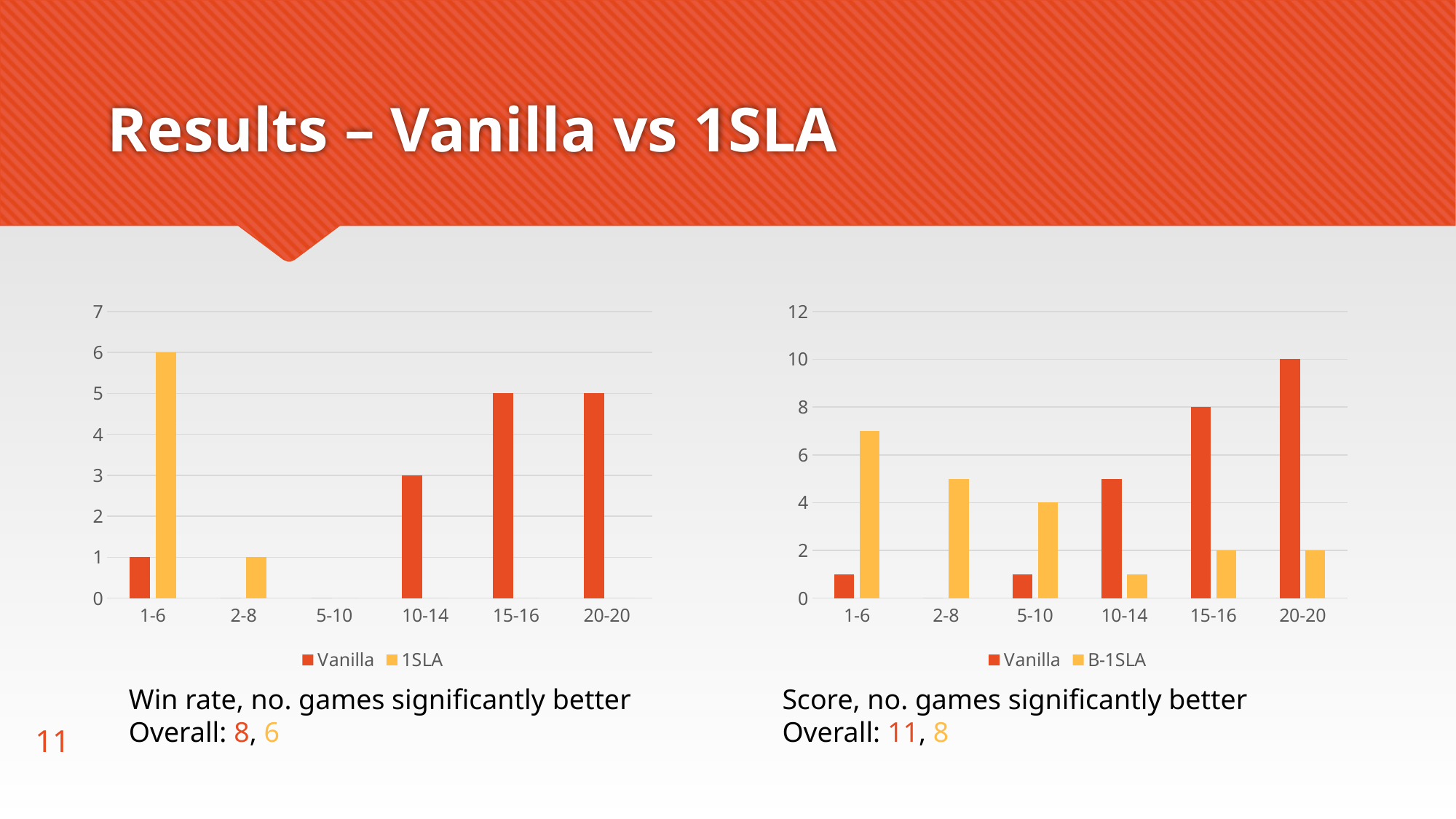
In the left chart (Win rate), how many series does the legend list? 2 In the right chart (Score), what is the value for B-1SLA at 5-10? 4 In the left chart (Win rate), what is the difference between the 1SLA value at 1-6 and the Vanilla value at 1-6? 5 What type of chart is the right chart (Score)? Bar chart In the left chart (Win rate), what is the value for 1SLA at 1-6? 6 In the right chart (Score), is the value for B-1SLA at 1-6 greater or less than 6? greater In the left chart (Win rate), what is the value for Vanilla at 10-14? 3 In the left chart (Win rate), which category has the highest Vanilla value? 15-16 and 20-20 (both 5) In the right chart (Score), which is larger at 2-8: Vanilla or B-1SLA? B-1SLA In the right chart (Score), how many categories are shown on the x axis? 6 In the right chart (Score), what is the value for Vanilla at 20-20? 10 In the right chart (Score), what is the value for Vanilla at 15-16? 8